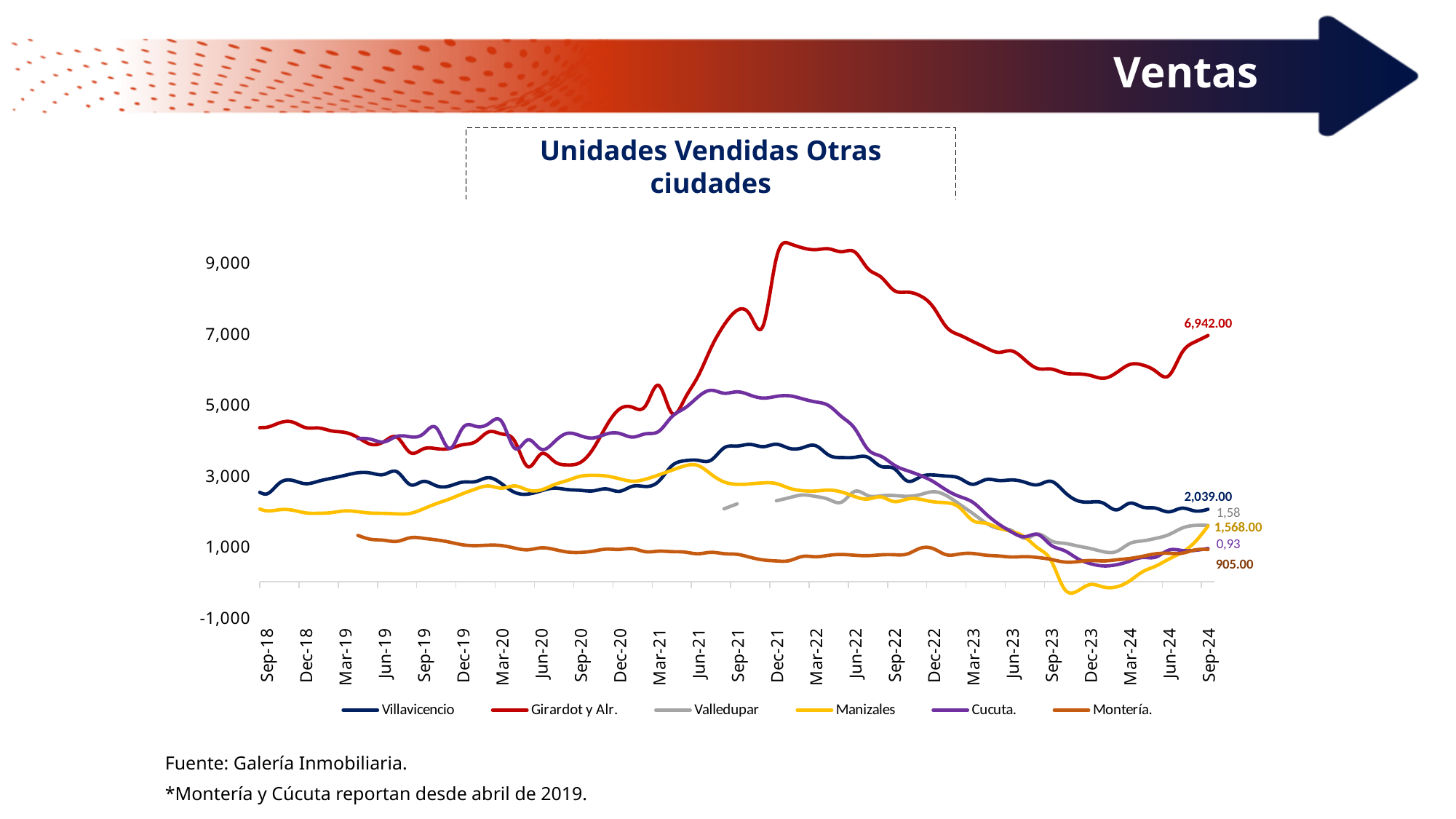
What kind of chart is shown on the slide? line chart What is the value labelled for Manizales at Sep-24? 1,568.00 Does the Girardot y Alr. line rise or fall between Dec-21 and Dec-23? fall What is the value labelled for Montería at Sep-24? 905.00 What is the value labelled for Villavicencio at Sep-24? 2,039.00 What is the difference between the Sep-24 values of Villavicencio and Manizales? 471.00 What is the value labelled for Girardot y Alr. at Sep-24? 6,942.00 Which series has the highest value at Sep-24? Girardot y Alr. What is the difference between the Sep-24 values of Girardot y Alr. and Villavicencio? 4,903.00 How many series does the legend list? 6 What is the title of the chart? Unidades Vendidas Otras ciudades